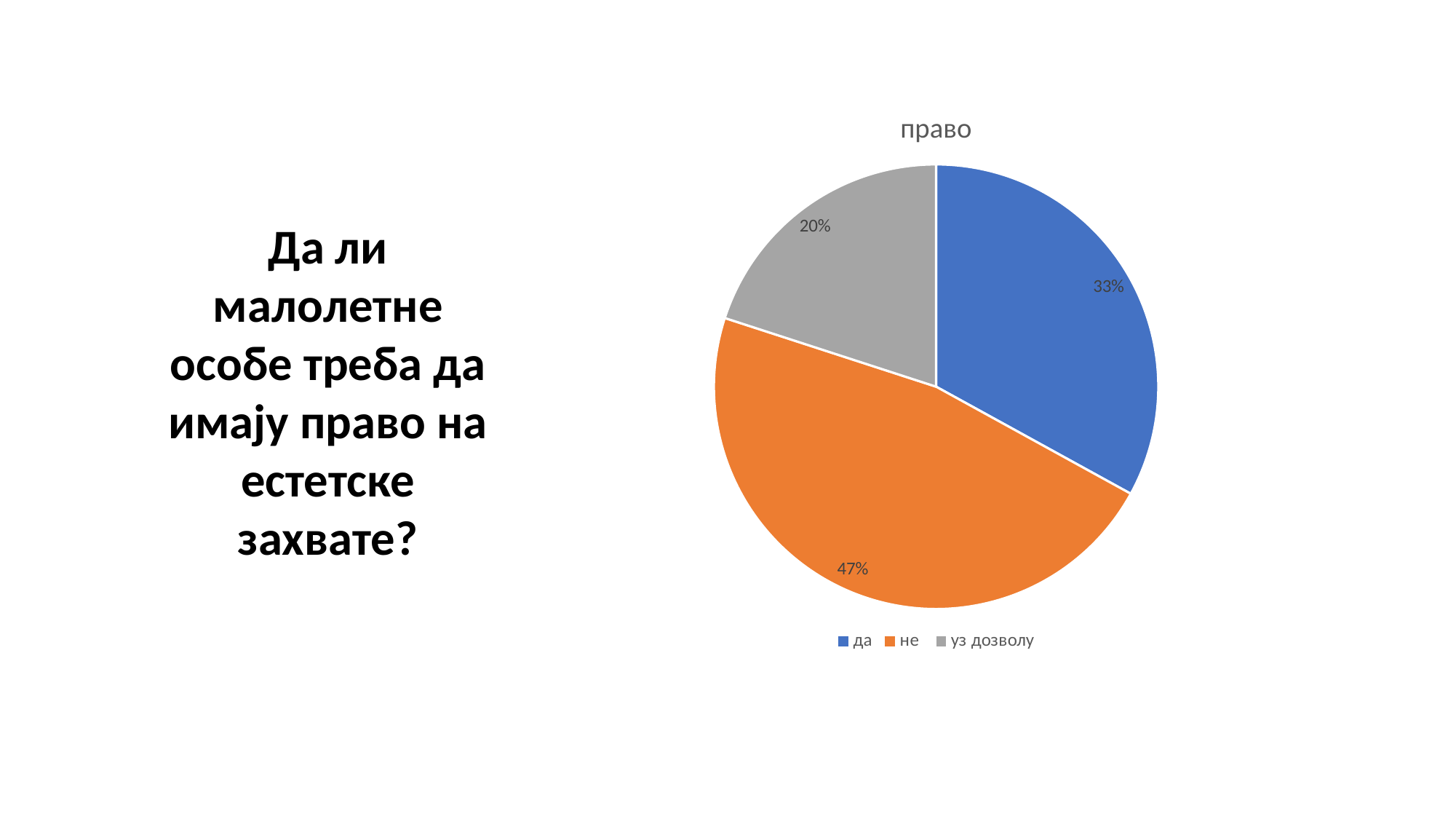
What is the title of the chart? право What percentage of the pie does the "уз дозволу" slice represent? 20% What type of chart is shown on the slide? pie chart How many slices does the pie chart have? 3 How many entries does the legend list? 3 What percentage of the pie does the "да" slice represent? 33% What colour is the "не" slice? orange What percentage of the pie does the "не" slice represent? 47% Which category has the largest share of the pie? не Which category has the smallest share of the pie? уз дозволу Which is larger, the "да" slice or the "уз дозволу" slice? да What is the difference in percentage points between the "не" and "да" slices? 14